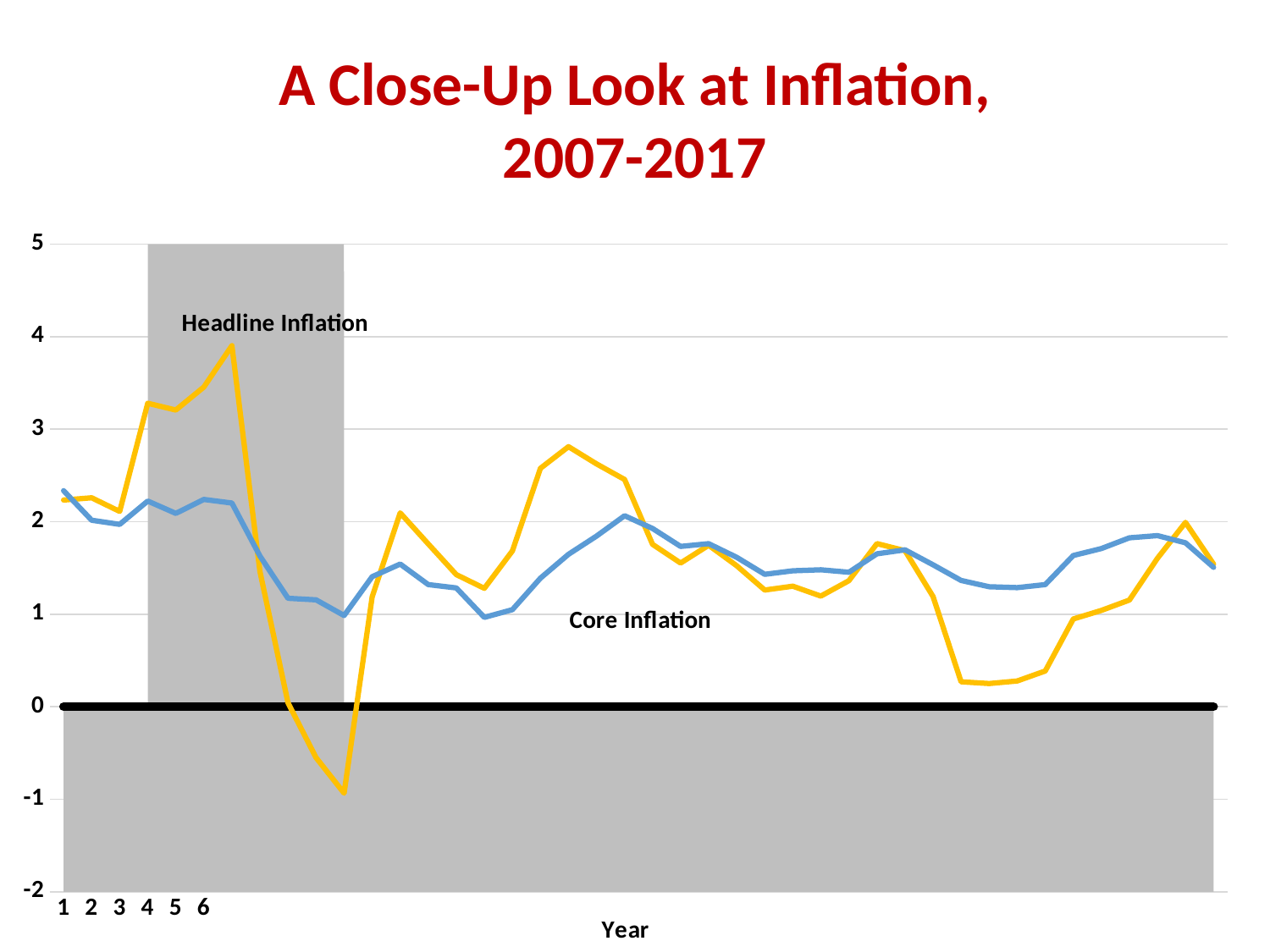
Is the Headline Inflation value at point 4 greater or less than 3? greater What kind of chart is shown on the slide? line chart What is the title of the chart on the slide? A Close-Up Look at Inflation, 2007-2017 What is the label on the x axis of the chart? Year Is the Core Inflation value at point 6 greater or less than 2? greater Does Headline Inflation rise or fall from point 1 to point 4? rise Is the Headline Inflation value at point 6 greater or less than 3? greater Which series drops below 0 on the chart? Headline Inflation At point 4, which series has the larger value, Headline Inflation or Core Inflation? Headline Inflation Which series reaches the highest value anywhere on the chart? Headline Inflation How many data series are plotted on the chart? 2